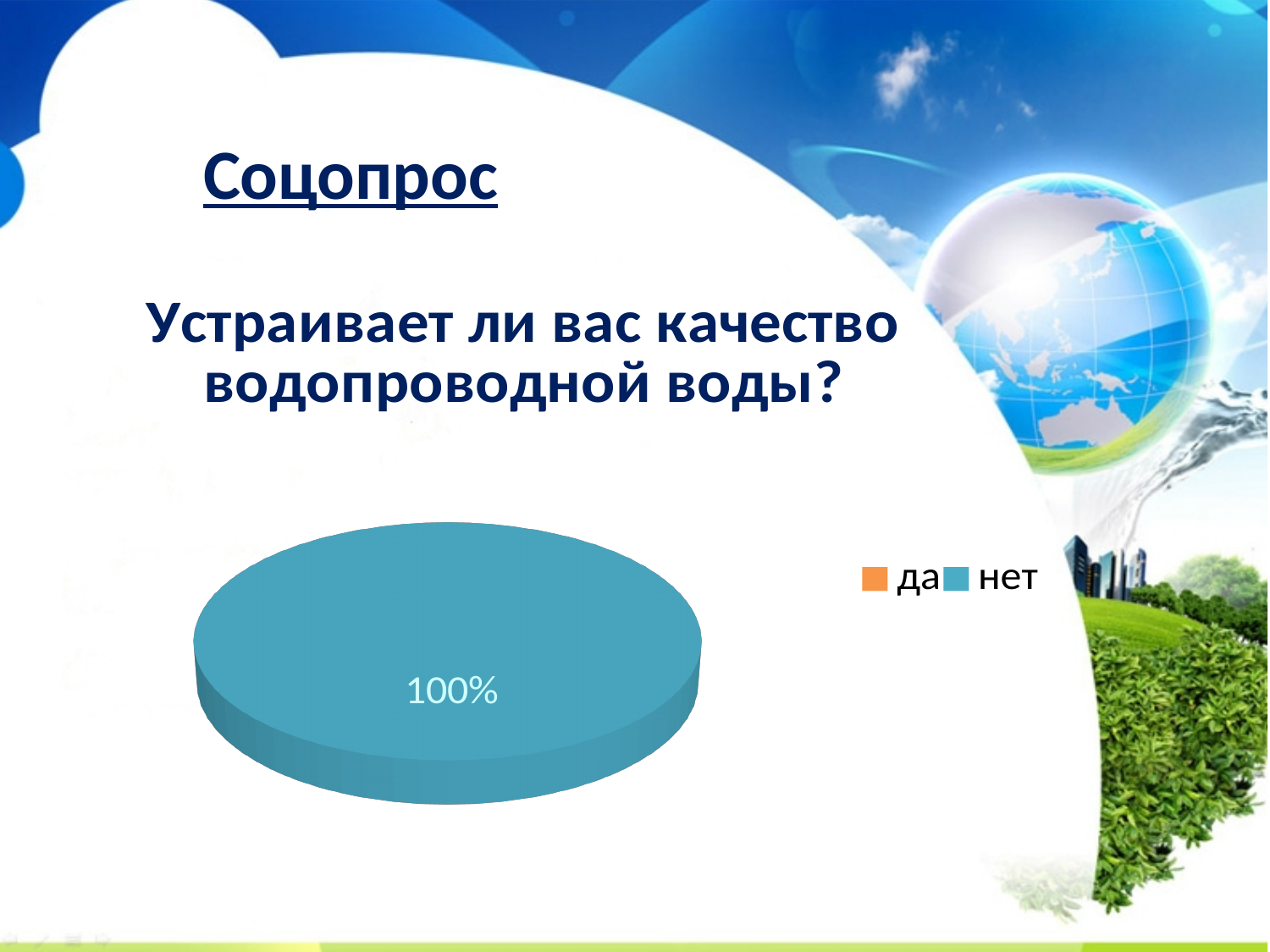
What survey question is the pie chart answering? Устраивает ли вас качество водопроводной воды? How many entries does the legend list? 2 Which is larger, the share for "да" or the share for "нет"? нет Which category has the largest share of the pie? нет Is the share for "нет" greater or less than 50%? greater What value is printed on the pie chart? 100% What colour is the "нет" slice in the legend? teal (blue) Which category has the smallest share of the pie? да What share of the pie does the "нет" slice take? 100% What kind of chart is shown on the slide? pie chart